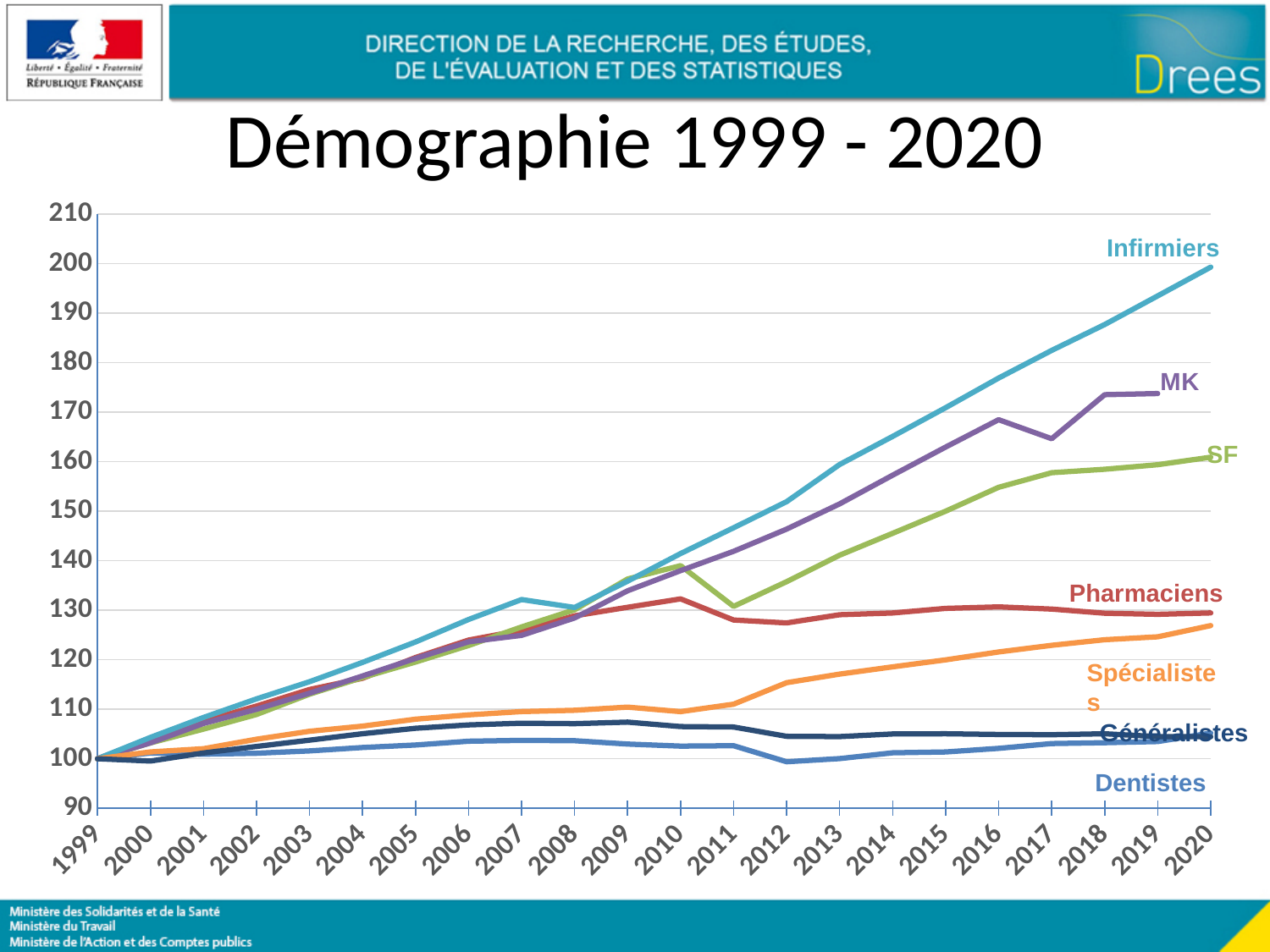
Which series has the highest value in 2020? Infirmiers In 2019, which is larger, the value for MK or the value for SF? MK Is the value for Dentistes in 2012 greater or less than 110? less How many years are shown along the x axis of the chart? 22 Is the value for Infirmiers in 2020 greater or less than 190? greater Does the Infirmiers series rise or fall from 1999 to 2020? rise Is the value for SF in 2020 greater or less than 150? greater How many series are labelled on the chart? 7 What kind of chart is shown on the slide? line chart In 2015, which is larger, the value for Pharmaciens or the value for Spécialistes? Pharmaciens What is the title of the chart? Démographie 1999 - 2020